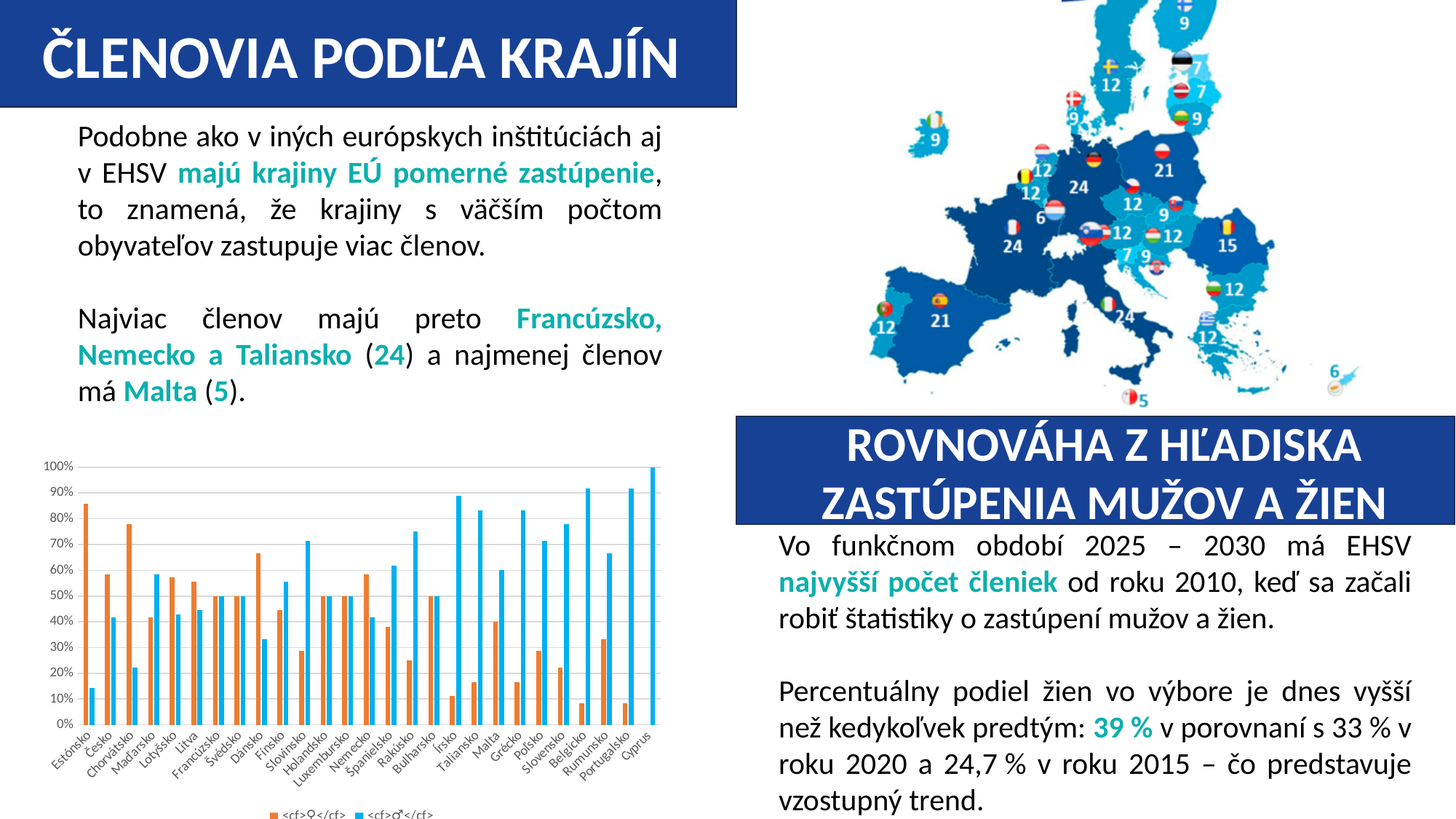
What kind of chart is shown at the bottom left of the slide? bar chart In the bar chart at the bottom left, what is the value of the blue bar for Cyprus? 100% In the bar chart at the bottom left, is the blue bar for Írsko greater or less than 80%? greater In the bar chart at the bottom left, what is the value of the orange bar for Francúzsko? 50% In the bar chart at the bottom left, which is larger for Taliansko, the orange bar or the blue bar? the blue bar In the bar chart at the bottom left, is the orange bar for Belgicko greater or less than 10%? less In the bar chart at the bottom left, how many countries are listed on the x axis? 27 In the bar chart at the bottom left, how many series does the legend list? 2 In the bar chart at the bottom left, is the orange bar for Estónsko greater or less than 80%? greater In the bar chart at the bottom left, which country has the lowest blue bar? Estónsko In the bar chart at the bottom left, which country has the highest orange bar? Estónsko In the bar chart at the bottom left, which country has the highest blue bar? Cyprus